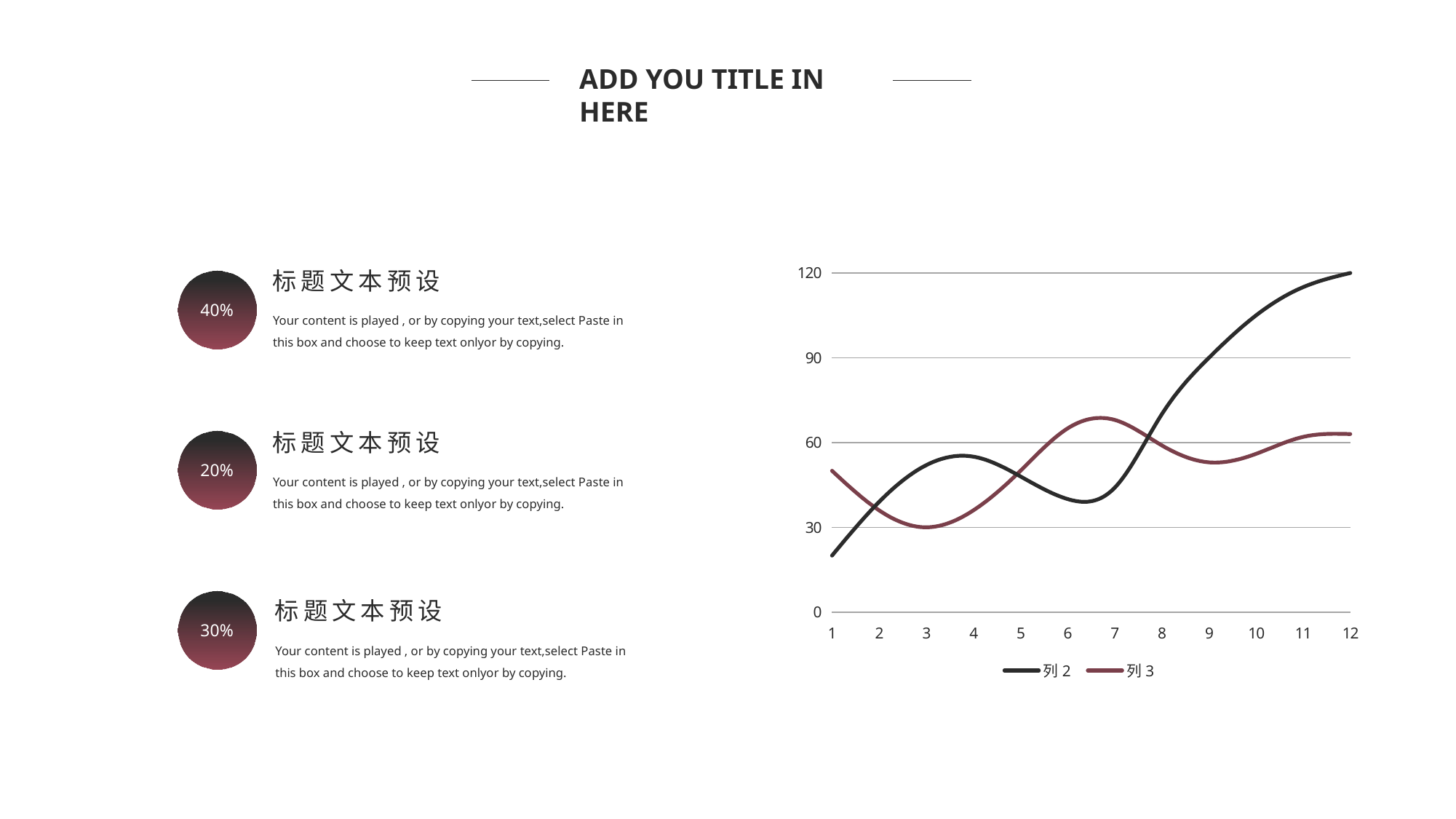
Does 列 2 rise or fall from x = 8 to x = 12? rise What kind of chart is shown on the slide? line chart How many points are plotted along the x axis for each series? 12 Is the value of 列 3 at x = 3 greater or less than 60? less Is the value of 列 2 at x = 1 greater or less than 30? less At x = 7, which series has the larger value, 列 2 or 列 3? 列 3 How many series does the chart legend list? 2 What is the value of 列 2 at x = 12? 120 Is the value of 列 2 at x = 9 greater or less than 60? greater At which x value does 列 2 reach its highest point? 12 At x = 12, which series has the larger value, 列 2 or 列 3? 列 2